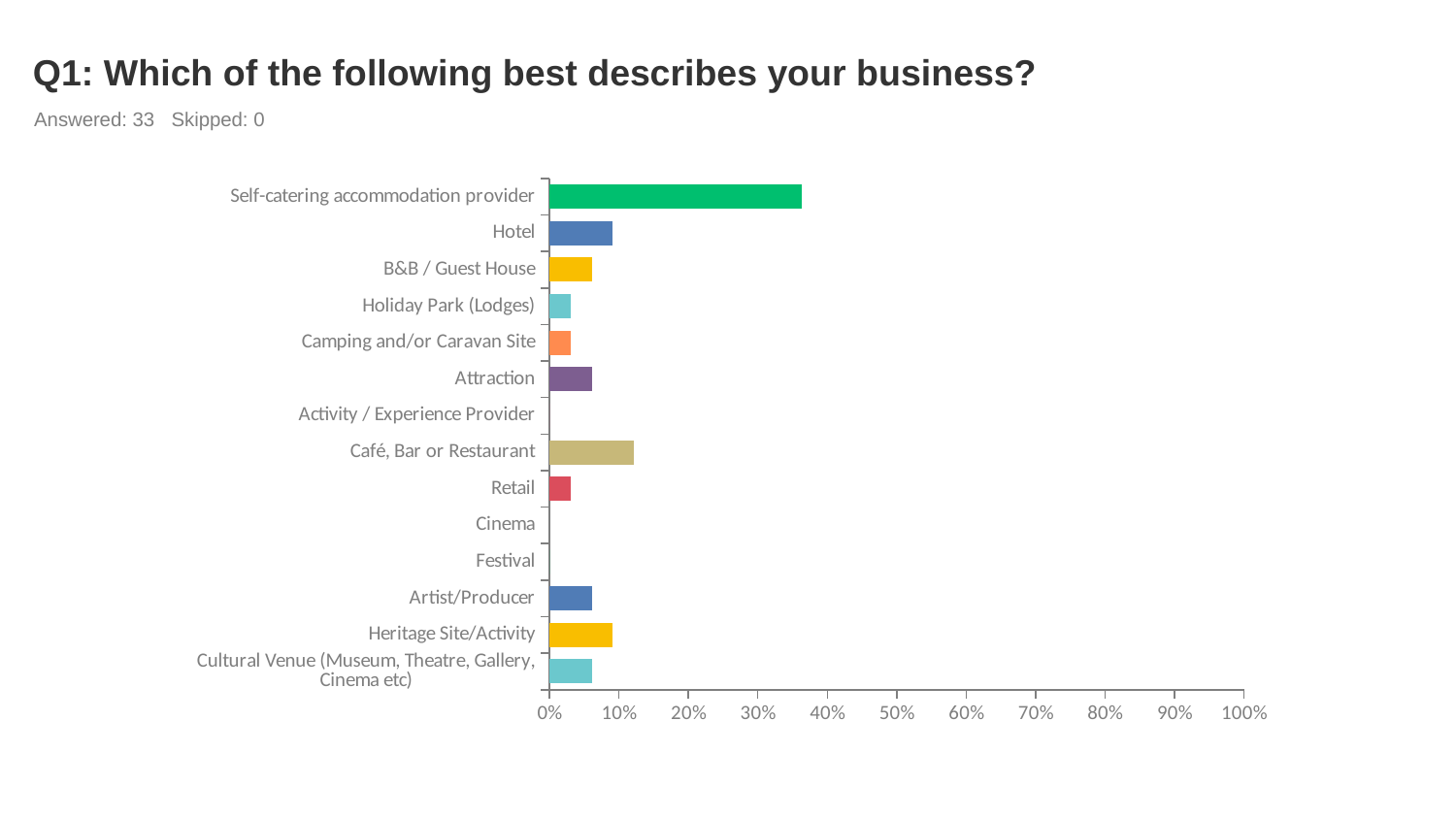
How many respondents answered the question according to the slide? 33 Is the value for Self-catering accommodation provider greater or less than 30%? greater What kind of chart is shown on the slide? bar chart What is the title of the chart? Q1: Which of the following best describes your business? Which is larger, the value for Heritage Site/Activity or the value for Holiday Park (Lodges)? Heritage Site/Activity Which is larger, the value for Attraction or the value for Retail? Attraction How many categories are listed on the vertical axis? 14 Is the value for Self-catering accommodation provider greater or less than 40%? less Which category has the highest value? Self-catering accommodation provider Is the value for Café, Bar or Restaurant greater or less than 10%? greater Which is larger, the value for Café, Bar or Restaurant or the value for Hotel? Café, Bar or Restaurant